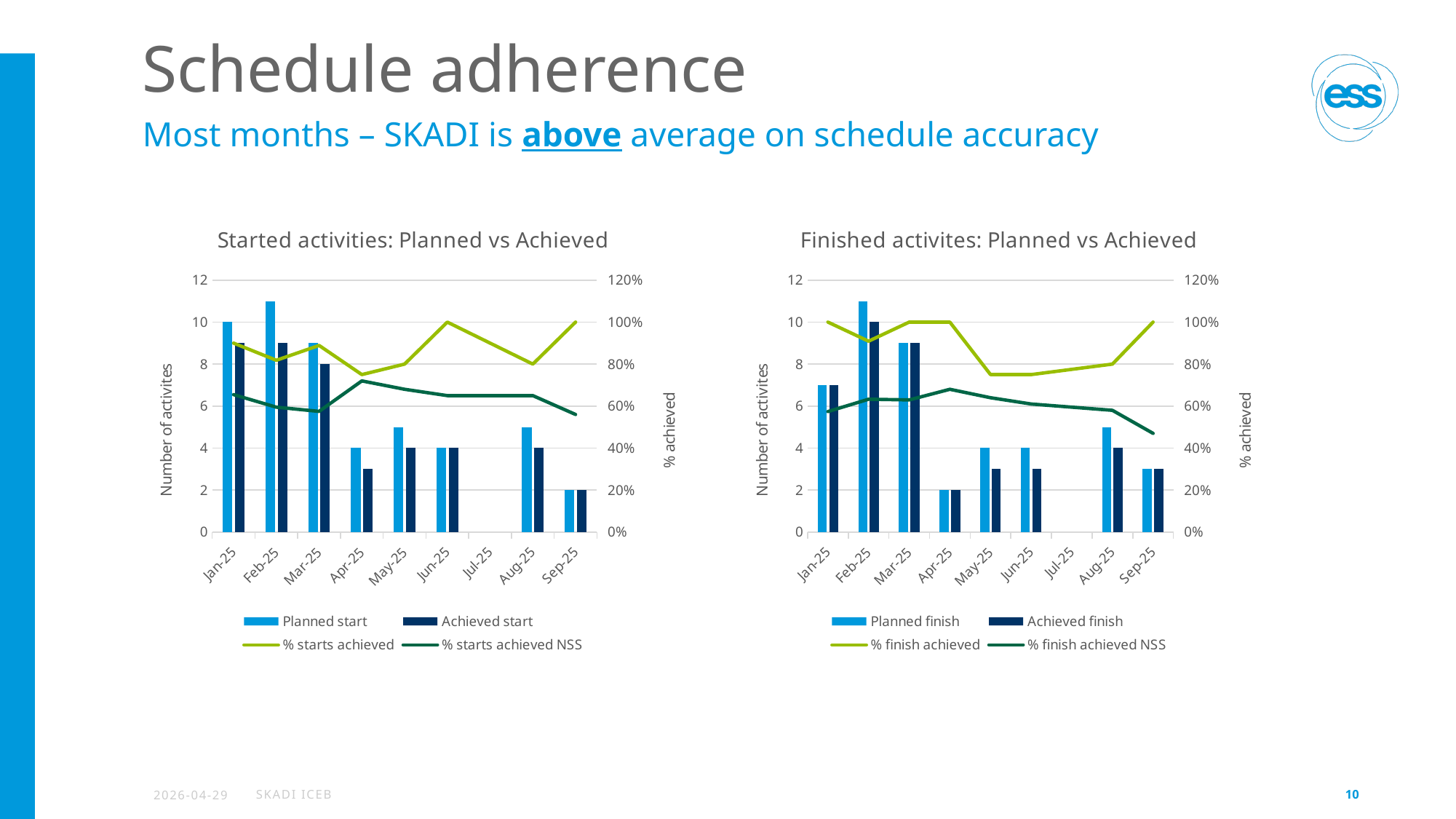
In the 'Finished activites: Planned vs Achieved' chart, what is the % finish achieved value for Aug-25? 80% In the 'Finished activites: Planned vs Achieved' chart, does the % finish achieved NSS line rise or fall from Apr-25 to Sep-25? fall In the 'Started activities: Planned vs Achieved' chart, is the Planned start value for Feb-25 greater or less than 10? greater How many series does the legend of the 'Finished activites: Planned vs Achieved' chart list? 4 In the 'Finished activites: Planned vs Achieved' chart, which month has the lowest Planned finish value? Apr-25 In the 'Started activities: Planned vs Achieved' chart, what is the Achieved start value for Mar-25? 8 In the 'Started activities: Planned vs Achieved' chart, what is the % starts achieved value for Jun-25? 100% In the 'Finished activites: Planned vs Achieved' chart, is the Planned finish value for Aug-25 larger or smaller than the Achieved finish value for Aug-25? larger In the 'Started activities: Planned vs Achieved' chart, what is the Planned start value for Jan-25? 10 In the 'Started activities: Planned vs Achieved' chart, which month has the highest Planned start value? Feb-25 In the 'Finished activites: Planned vs Achieved' chart, what is the Achieved finish value for Feb-25? 10 In the 'Started activities: Planned vs Achieved' chart, what is the difference between the Planned start values for Jan-25 and Apr-25? 6